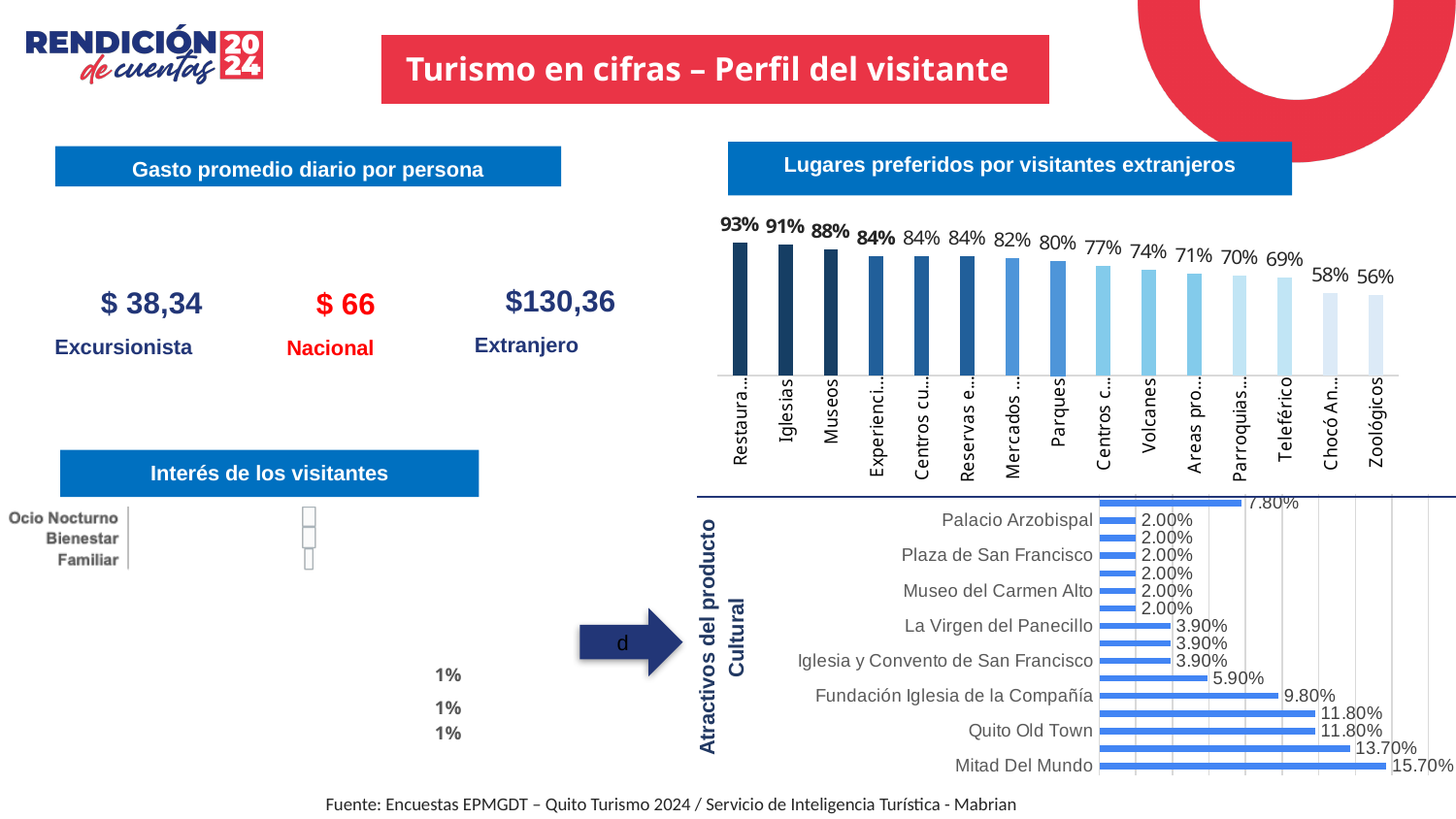
In the 'Lugares preferidos por visitantes extranjeros' chart, what is the difference between Iglesias and Museos? 3 percentage points Do the values in the 'Lugares preferidos por visitantes extranjeros' chart rise or fall from left to right? Fall How many bars are in the 'Lugares preferidos por visitantes extranjeros' chart? 15 In the 'Lugares preferidos por visitantes extranjeros' chart, what is the value for Iglesias? 91% What kind of chart is the 'Atractivos del producto Cultural' chart at the bottom right? Bar chart In the 'Atractivos del producto Cultural' chart, what is the value for Mitad Del Mundo? 15.70% In the 'Atractivos del producto Cultural' chart, what is the value for Fundación Iglesia de la Compañía? 9.80% In the 'Lugares preferidos por visitantes extranjeros' chart, what is the value for Museos? 88% In the 'Lugares preferidos por visitantes extranjeros' chart, which is larger, Parques or Volcanes? Parques In the 'Atractivos del producto Cultural' chart, what is the difference between Mitad Del Mundo and Quito Old Town? 3.90 percentage points In the 'Lugares preferidos por visitantes extranjeros' chart, which category has the lowest value? Zoológicos In the 'Lugares preferidos por visitantes extranjeros' chart, what is the value for Teleférico? 69%